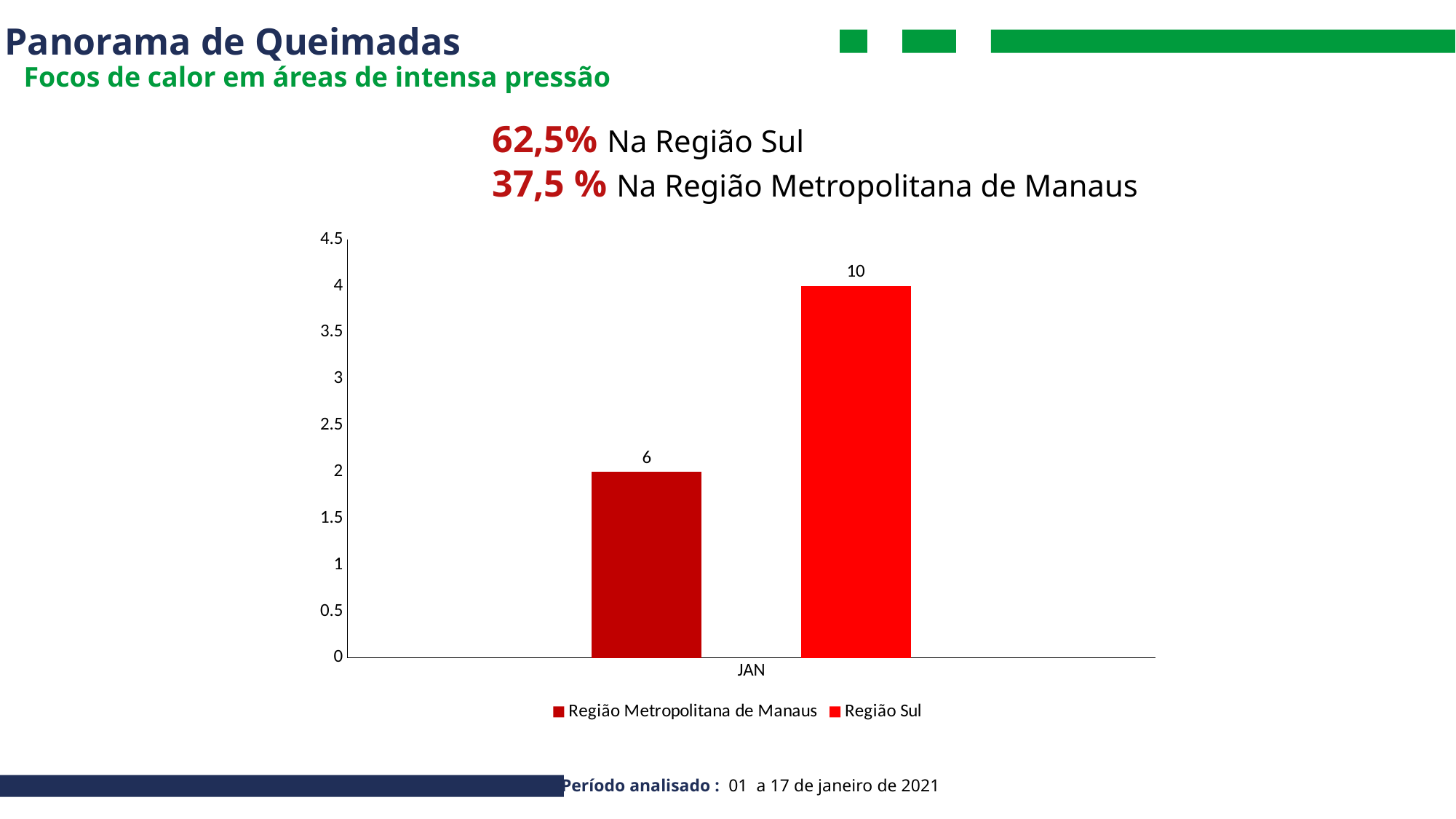
What kind of chart is shown on the slide? bar chart What is the difference between the data labels for Região Sul and Região Metropolitana de Manaus? 4 What is the data label on the bar for Região Metropolitana de Manaus? 6 Which series has the highest labelled value? Região Sul How many series does the legend list? 2 What is the highest value shown on the y axis? 4.5 What is the data label on the bar for Região Sul? 10 What is the label of the category on the x axis? JAN Which series has the lowest labelled value? Região Metropolitana de Manaus How many categories are shown on the x axis? 1 Which series has the taller bar, Região Metropolitana de Manaus or Região Sul? Região Sul